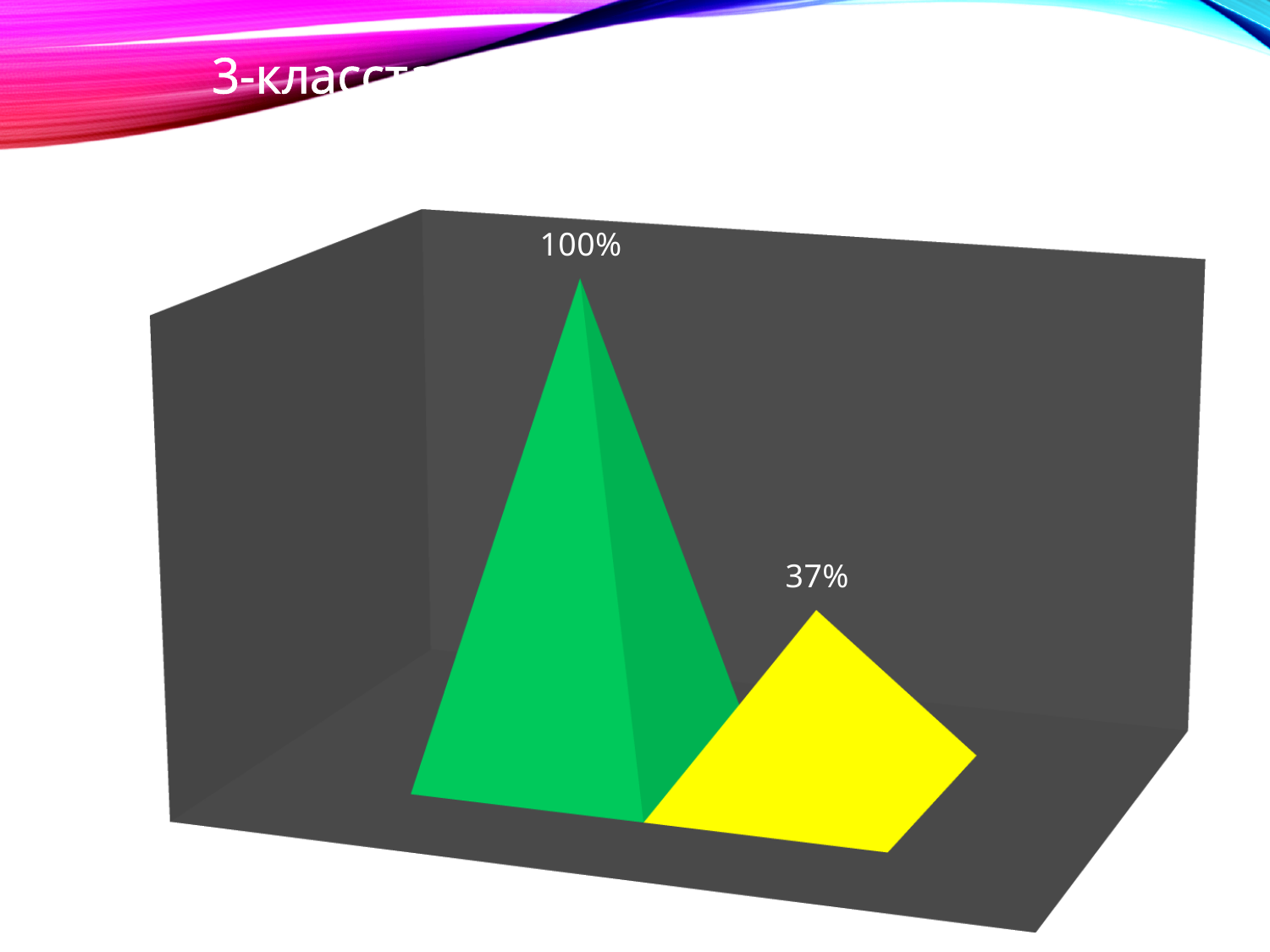
Is the value of the yellow pyramid larger or smaller than the value of the green pyramid? smaller What kind of chart is shown on the slide? a 3D bar chart (pyramid-shaped bars) Which pyramid has the lowest value, the green one or the yellow one? the yellow one What is the difference between the value of the green pyramid and the value of the yellow pyramid? 63% What colour is the pyramid labelled 37%? yellow What value is shown on the green pyramid? 100% What value is shown on the yellow pyramid? 37% Do the values rise or fall from left to right across the chart? fall How many data points (pyramids) are plotted on the chart? 2 Which pyramid has the highest value, the green one or the yellow one? the green one What colour is the pyramid labelled 100%? green